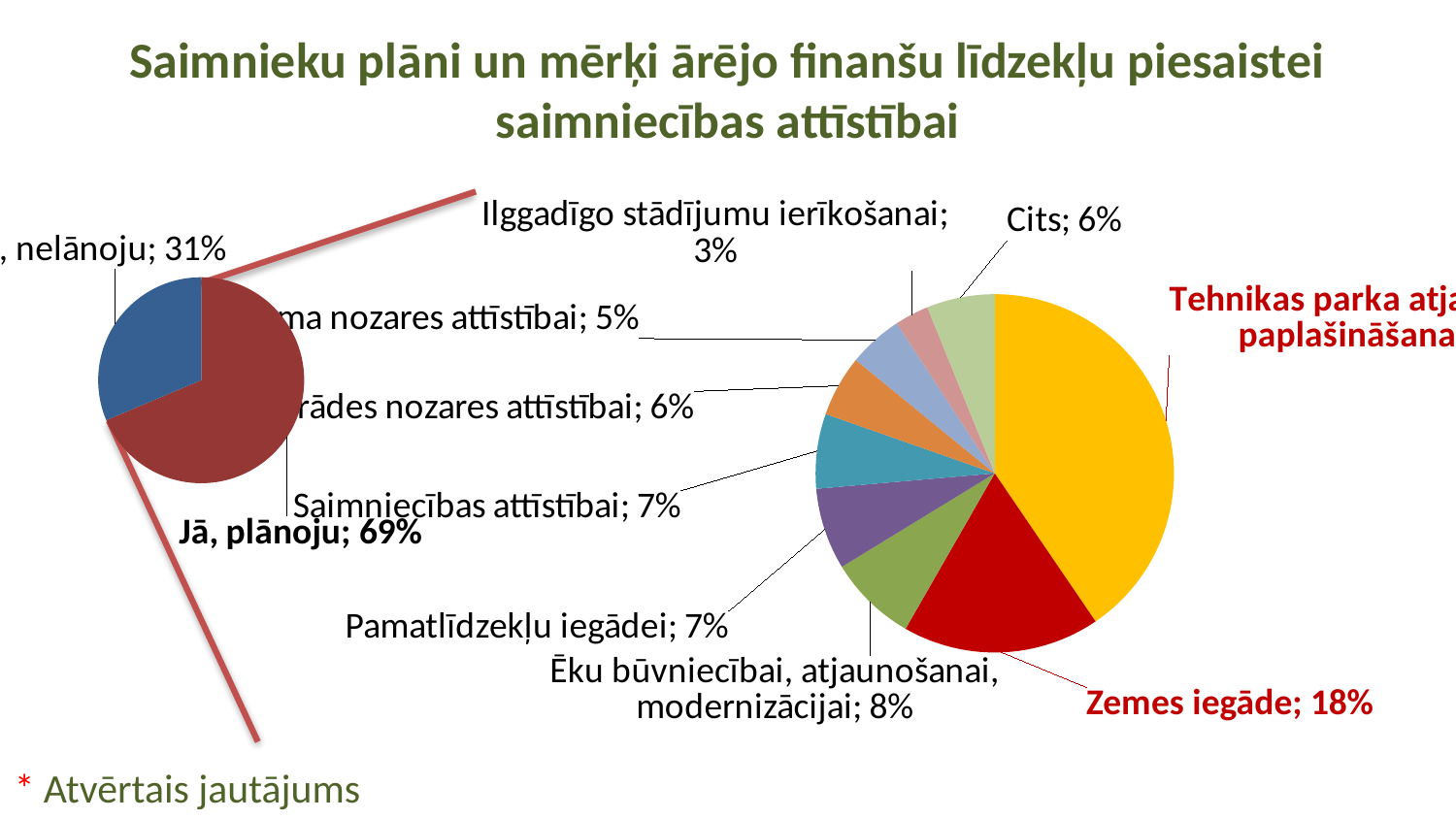
In the large pie chart on the right, what share is labelled "Ēku būvniecībai, atjaunošanai, modernizācijai"? 8% In the large pie chart on the right, what share is labelled "Cits"? 6% In the large pie chart on the right, what share is labelled "Zemes iegāde"? 18% What kind of chart is the large chart on the right side of the slide? Pie chart In the large pie chart on the right, what share is labelled "Ilggadīgo stādījumu ierīkošanai"? 3% In the small pie chart on the left, what is the difference in percentage points between the 69% slice and the 31% slice? 38 percentage points In the large pie chart on the right, which labelled category has the smallest share? Ilggadīgo stādījumu ierīkošanai In the large pie chart on the right, what is the difference in percentage points between Zemes iegāde and Ēku būvniecībai, atjaunošanai, modernizācijai? 10 percentage points How many slices does the large pie chart on the right have? 9 In the small pie chart on the left, what share is labelled "Jā, plānoju"? 69% In the large pie chart on the right, which is larger: Zemes iegāde or Pamatlīdzekļu iegādei? Zemes iegāde In the small pie chart on the left, which of the two slices is larger? Jā, plānoju